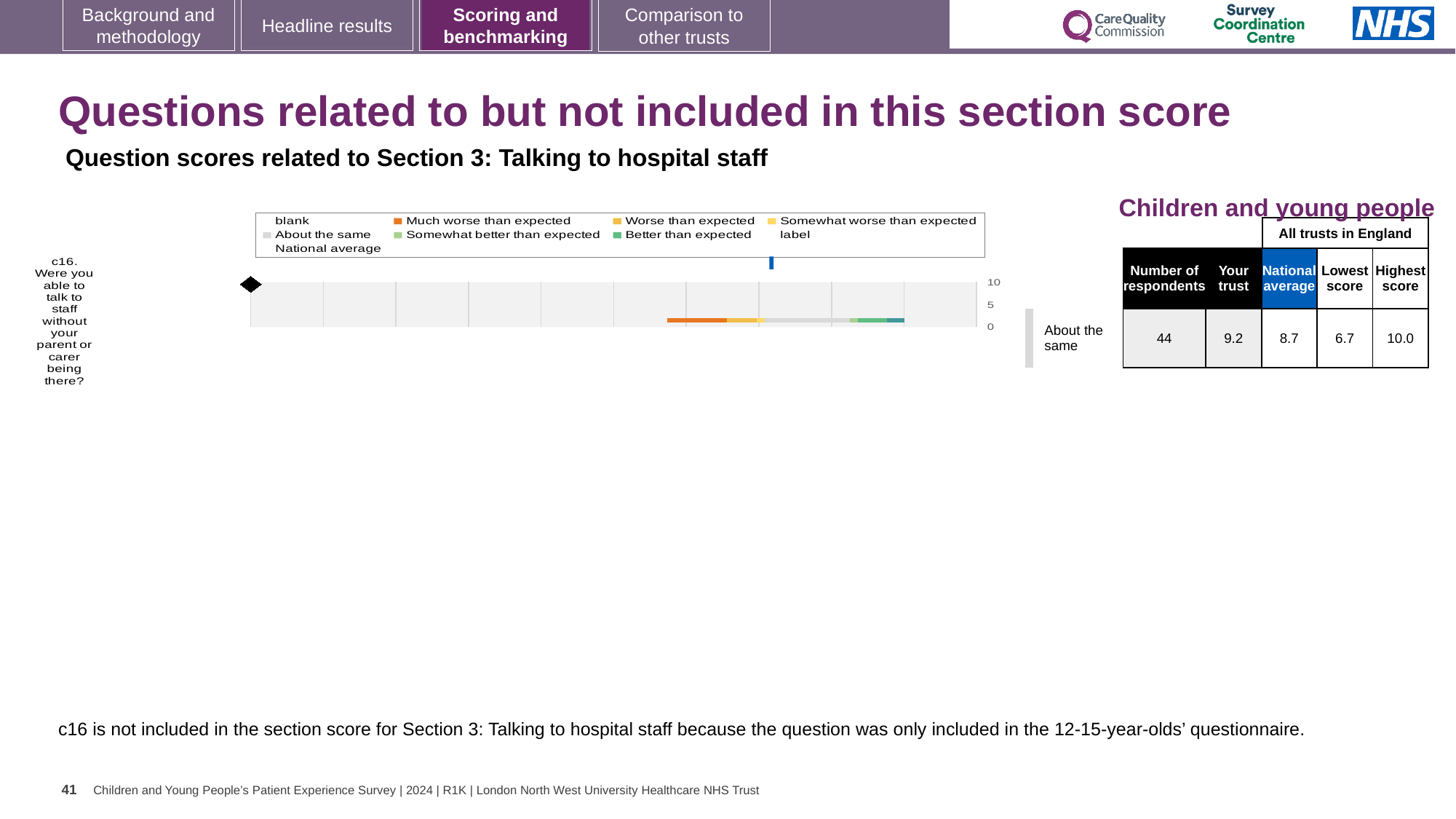
What kind of chart is shown for question c16? bar chart In the table next to the chart, what is the lowest score among all trusts in England for c16? 6.7 What is the highest value shown on the chart's axis? 10 Which question is plotted in the chart? c16. Were you able to talk to staff without your parent or carer being there? What is the difference between the 'Your trust' score and the national average for c16? 0.5 What colour does the legend use for 'Much worse than expected'? orange Which is larger for c16: the 'Your trust' score or the national average? Your trust In the table next to the chart, what is the 'Your trust' score for c16? 9.2 How many questions (categories) are plotted in the chart? 1 In the table next to the chart, what is the highest score among all trusts in England for c16? 10.0 In the table next to the chart, what is the national average score for c16? 8.7 In the table next to the chart, what is the number of respondents for c16? 44